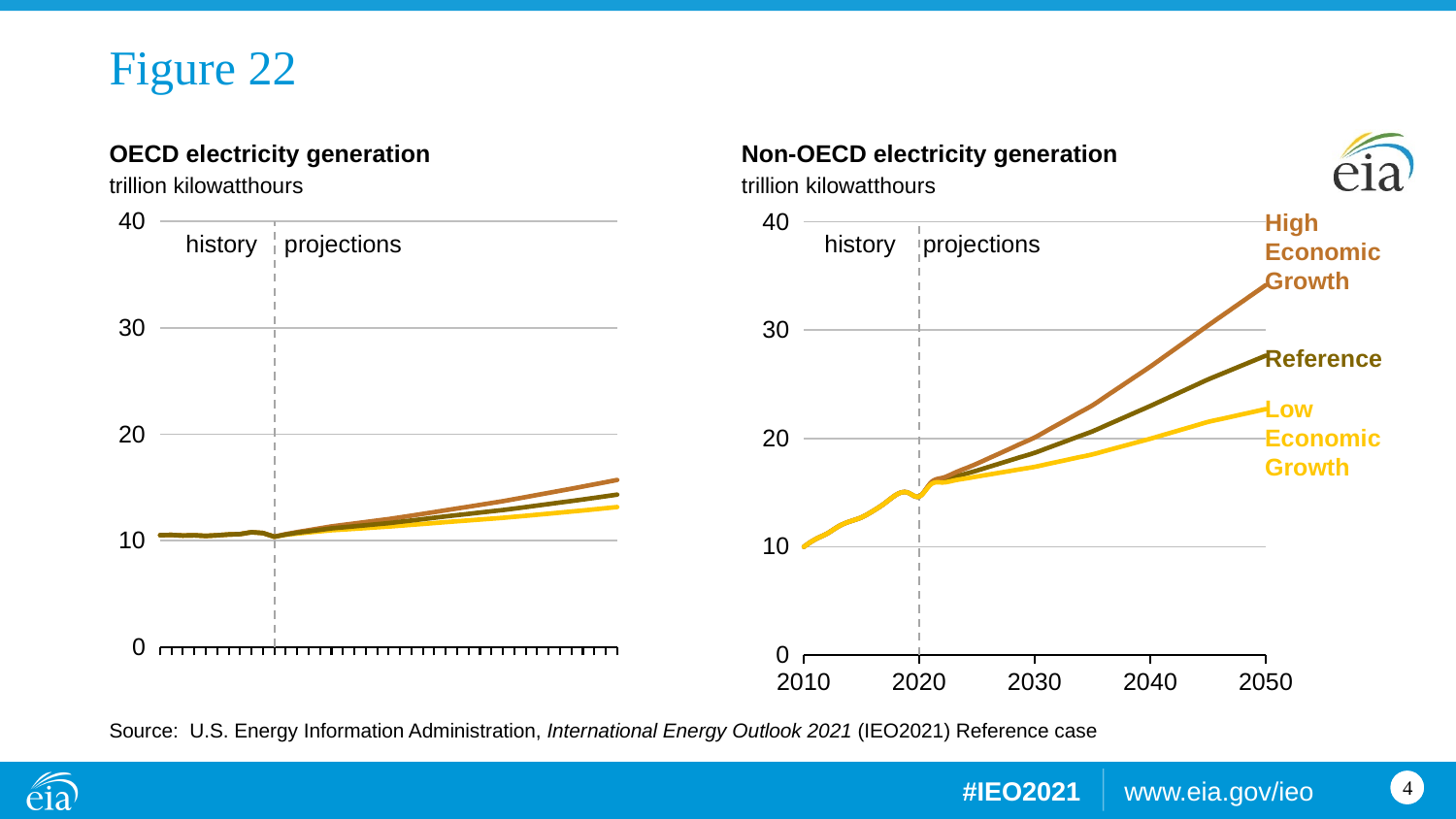
What kind of chart is the OECD electricity generation chart? line chart What does the vertical dashed line on each chart separate? history and projections On the Non-OECD electricity generation chart, which is larger in 2050: the High Economic Growth value or the Reference value? High Economic Growth On the Non-OECD electricity generation chart, is the Reference value in 2050 greater or less than 30? less How many scenario lines are shown on the Non-OECD electricity generation chart? 3 What unit is used on the y axis of both charts? trillion kilowatthours On the Non-OECD electricity generation chart, do the values rise or fall from 2010 to 2050? rise On the OECD electricity generation chart, is the High Economic Growth line at the end of the projection period greater or less than 20? less On the Non-OECD electricity generation chart, which scenario has the lowest value in 2050? Low Economic Growth On the Non-OECD electricity generation chart, is the Low Economic Growth value in 2050 greater or less than 20? greater On the Non-OECD electricity generation chart, which scenario has the highest value in 2050? High Economic Growth